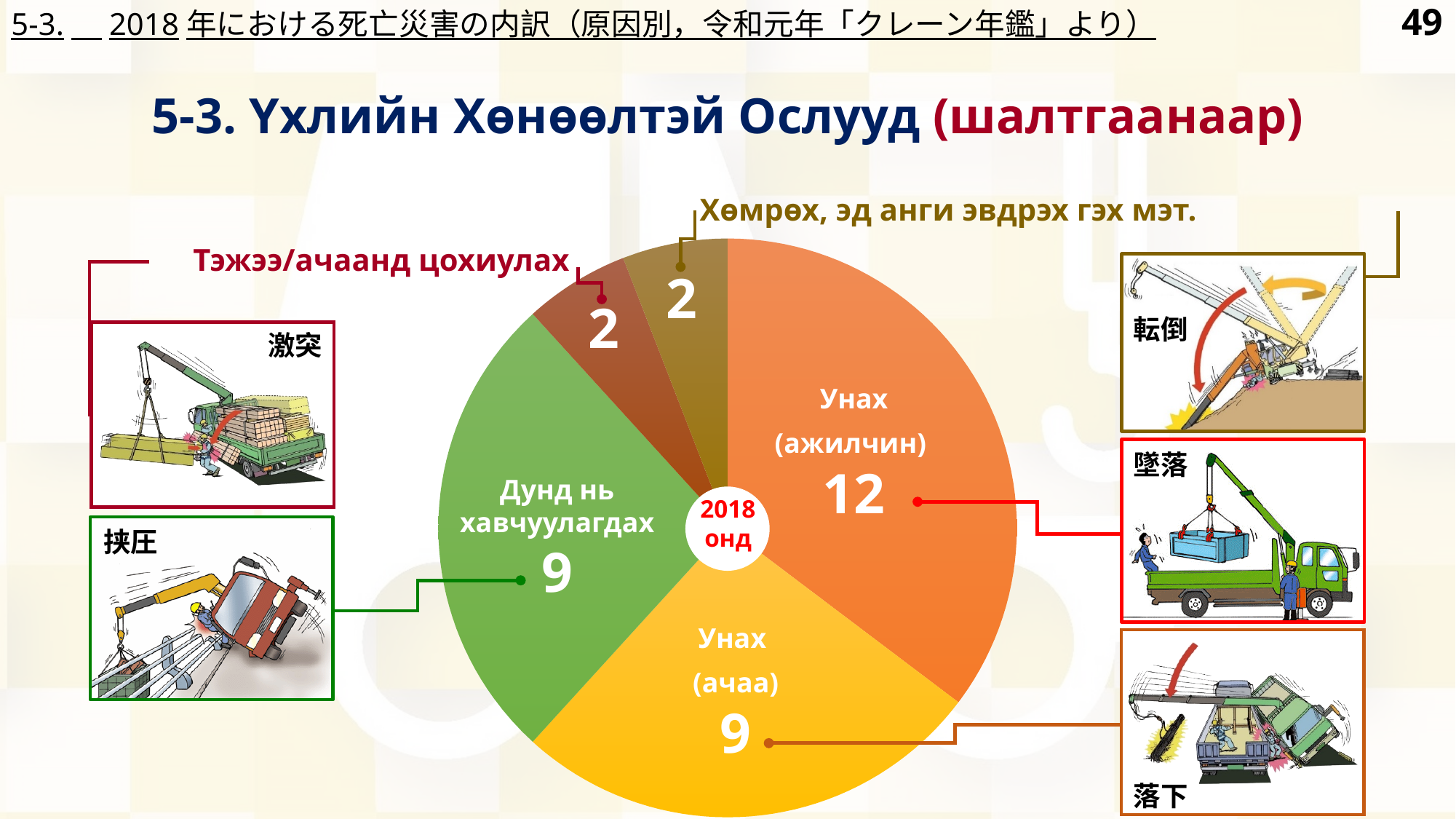
What is the total of all the values shown in the pie chart? 34 How many slices does the pie chart have? 5 What is the value for Дунд нь хавчуулагдах in the pie chart? 9 What year is written in the centre of the pie chart? 2018 онд What is the value for Унах (ачаа) in the pie chart? 9 What kind of chart is shown on the slide? pie chart What is the difference between the values for Унах (ажилчин) and Унах (ачаа)? 3 Which is larger, the value for Дунд нь хавчуулагдах or the value for Тэжээ/ачаанд цохиулах? Дунд нь хавчуулагдах What is the value for Тэжээ/ачаанд цохиулах in the pie chart? 2 Which category has the largest slice in the pie chart? Унах (ажилчин) What is the value for Хөмрөх, эд анги эвдрэх гэх мэт. in the pie chart? 2 What is the value for Унах (ажилчин) in the pie chart? 12